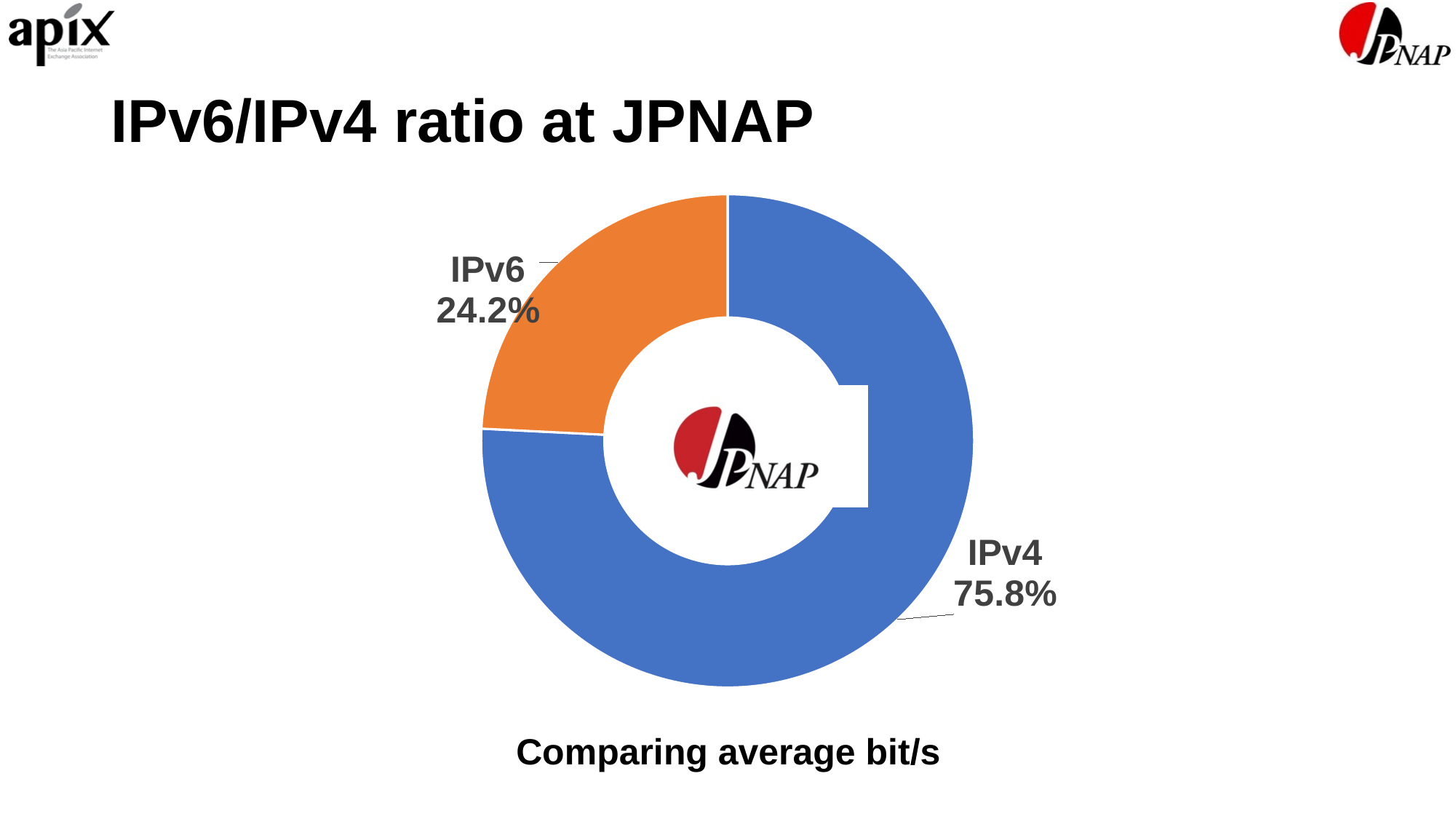
Which is larger, the IPv4 share or the IPv6 share? IPv4 What is the difference in percentage points between the IPv4 and IPv6 shares? 51.6 Which category has the smallest slice? IPv6 What kind of chart is shown on the slide? Pie chart (doughnut) What share of the chart does IPv6 account for? 24.2% How many categories are shown in the chart? 2 What colour is the IPv6 slice? Orange What share of the chart does IPv4 account for? 75.8% What is the title of the slide? IPv6/IPv4 ratio at JPNAP Which category has the largest slice? IPv4 What is the total of the two slices shown? 100%